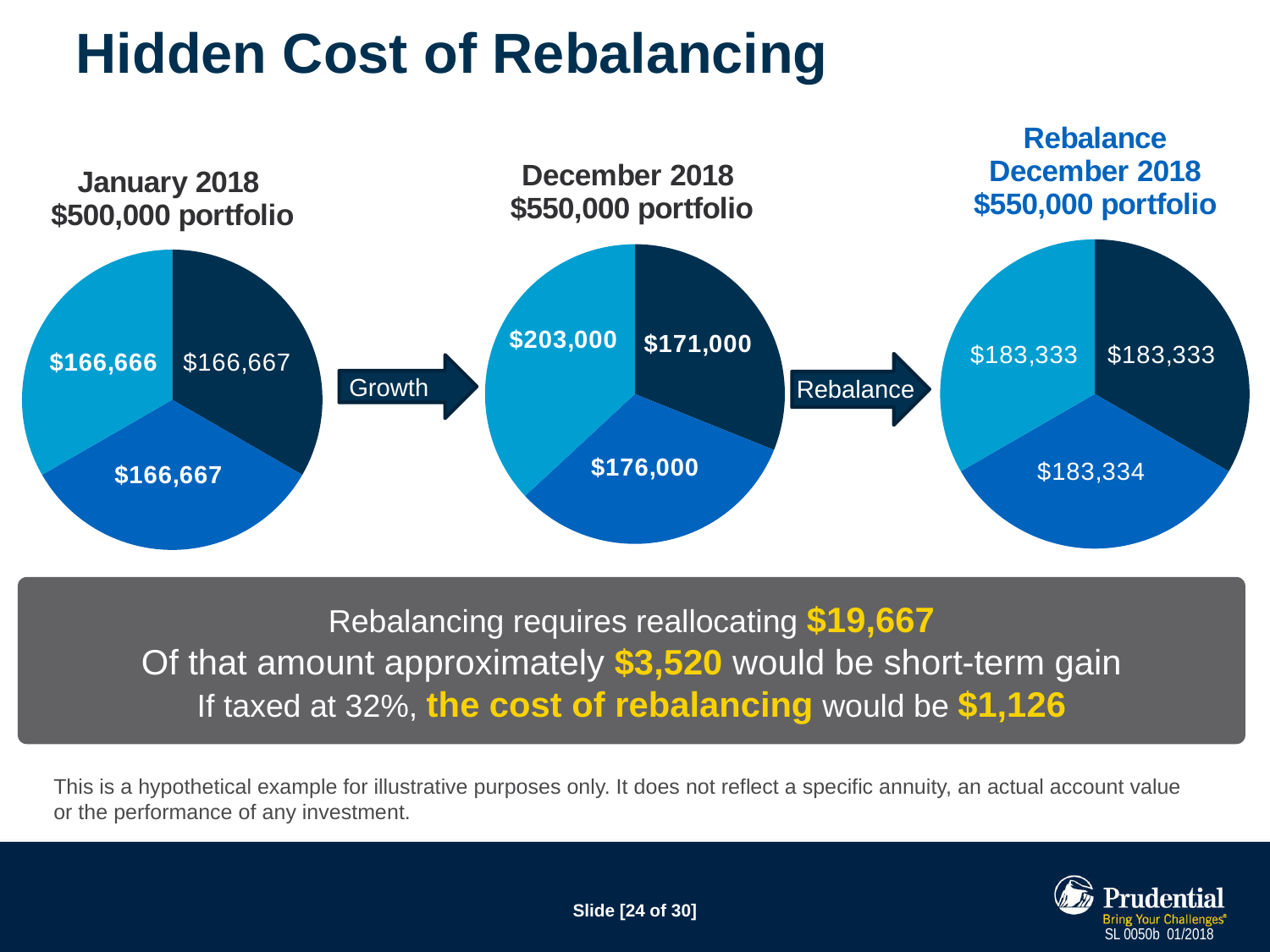
In the December 2018 $550,000 portfolio pie chart, what is the value of the light blue slice? $203,000 In the December 2018 $550,000 portfolio pie chart, what is the value of the dark navy slice? $171,000 In the December 2018 $550,000 portfolio pie chart, which slice has the smallest value? The dark navy slice ($171,000) In the Rebalance December 2018 $550,000 portfolio pie chart, what is the value of the bottom medium blue slice? $183,334 In the December 2018 $550,000 portfolio pie chart, what is the total of the three slices? $550,000 In the December 2018 $550,000 portfolio pie chart, which is larger: the medium blue slice or the dark navy slice? The medium blue slice ($176,000) In the December 2018 $550,000 portfolio pie chart, which slice has the largest value? The light blue slice ($203,000) In the January 2018 $500,000 portfolio pie chart, what is the value of the light blue slice? $166,666 What kind of chart is used to show the portfolios on this slide? Pie chart How many pie charts are shown on the slide? 3 How many slices does the January 2018 $500,000 portfolio pie chart have? 3 In the December 2018 $550,000 portfolio pie chart, what is the difference between the light blue slice and the dark navy slice? $32,000